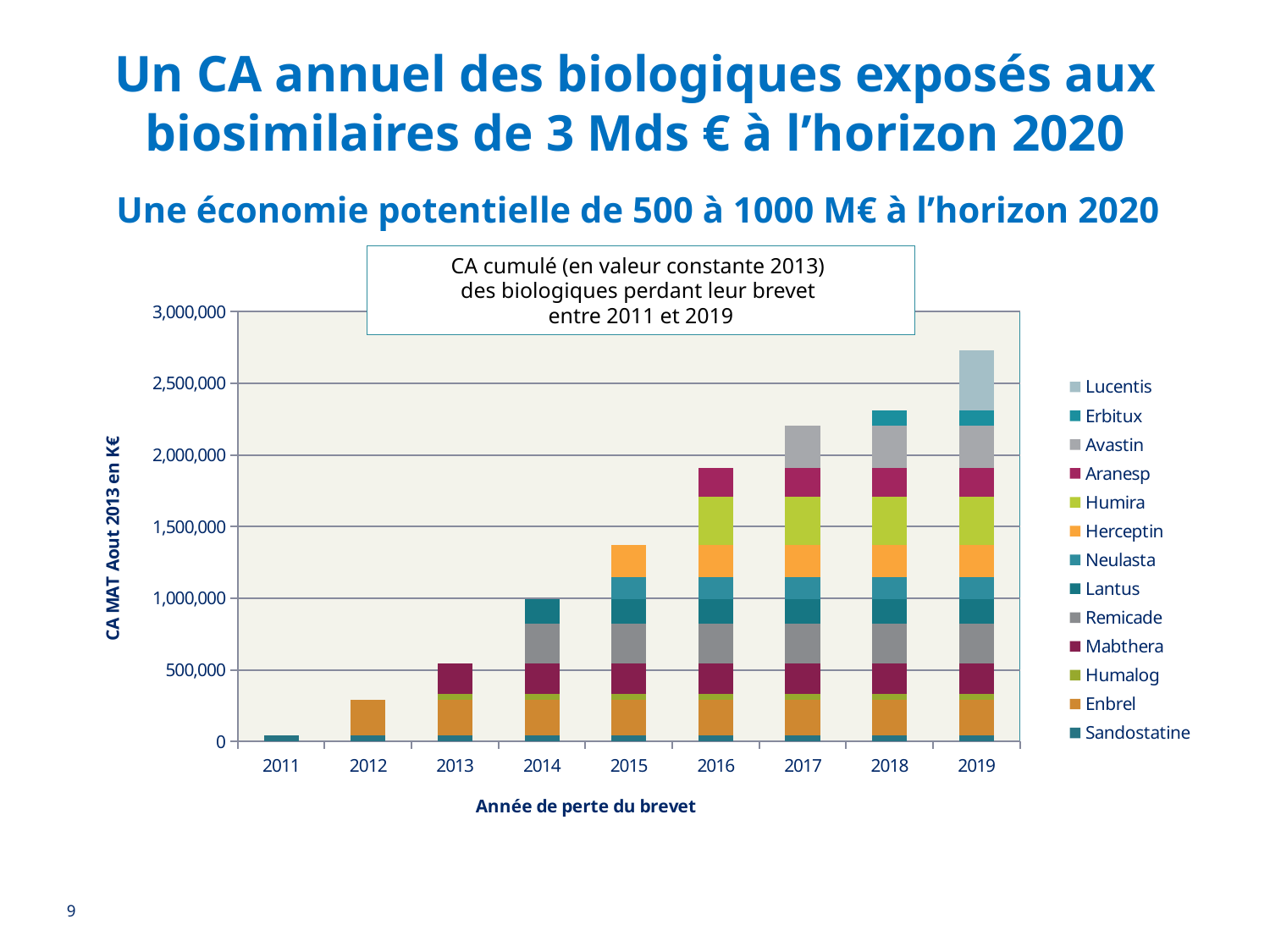
Is the total value for 2016 greater or less than 2,000,000? less Which year has the larger total bar, 2017 or 2018? 2018 Is the total value for 2019 greater or less than 2,500,000? greater Is the total value for 2012 greater or less than 500,000? less How many years are shown on the x axis of the chart? 9 Do the total bar heights rise or fall from 2011 to 2019? rise How many series does the chart's legend list? 13 Which year has the highest total cumulative CA in the chart? 2019 What kind of chart is shown on the slide? stacked bar chart What is the label of the chart's x axis? Année de perte du brevet Which year has the lowest total cumulative CA in the chart? 2011